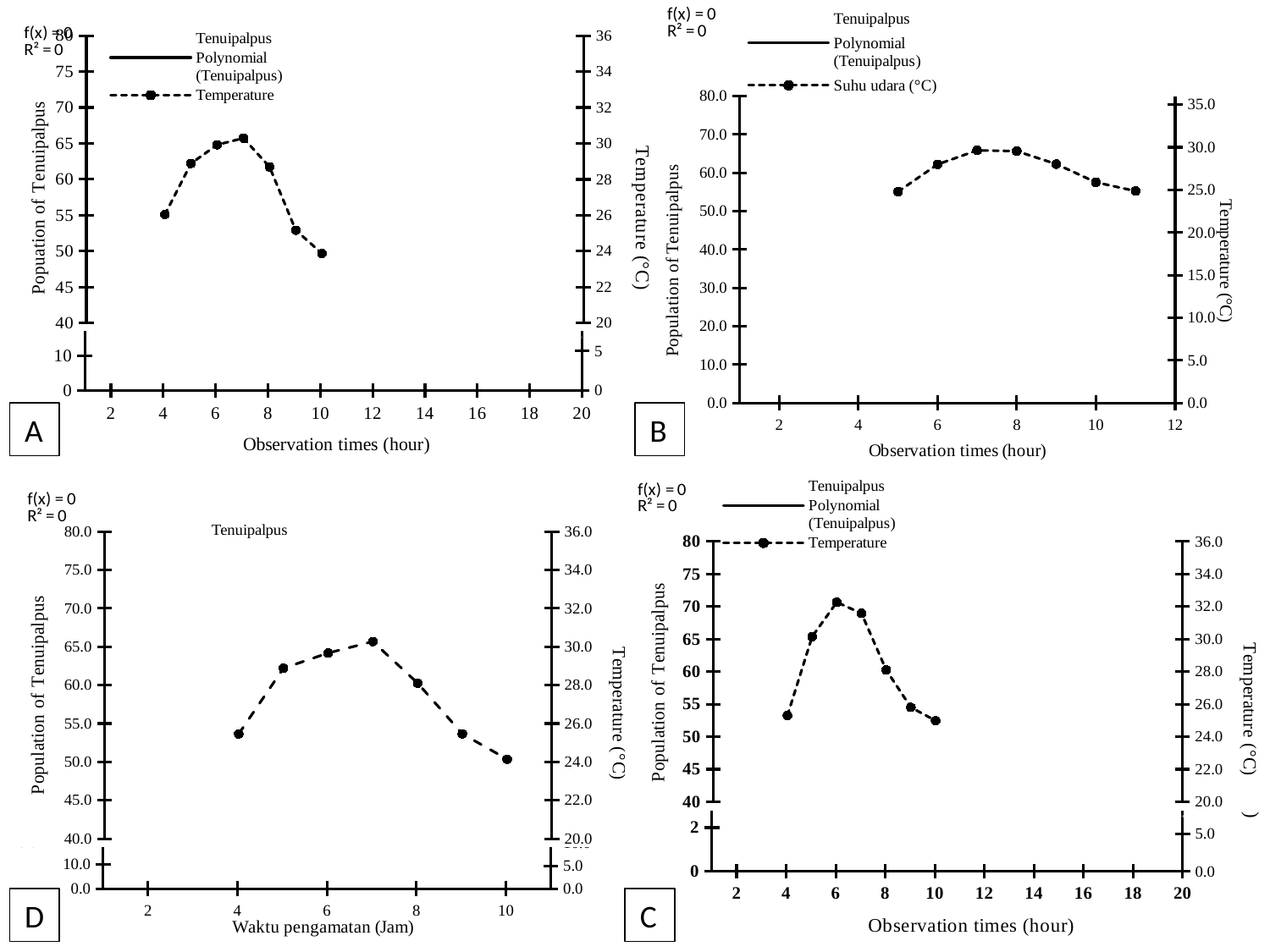
In chart D, at which observation time is the temperature lowest? 10 In chart C, is the temperature at observation time 6 greater or less than 30.0? greater In chart B, how many data points are plotted on the Suhu udara (°C) line? 7 In chart B, is the temperature at observation time 7 greater or less than 25.0? greater In chart A, at which observation time is the temperature highest? 7 In chart A, how many data points are plotted on the Temperature line? 7 In chart C, do the temperature values rise or fall from observation time 6 to observation time 10? fall In chart D, what is the x-axis title? Waktu pengamatan (Jam) What kind of chart is chart A? line chart In chart B, what is the label of the dashed line series in the legend? Suhu udara (°C) In chart C, at which observation time is the temperature highest? 6 In chart A, is the temperature at observation time 10 greater or less than 26? less